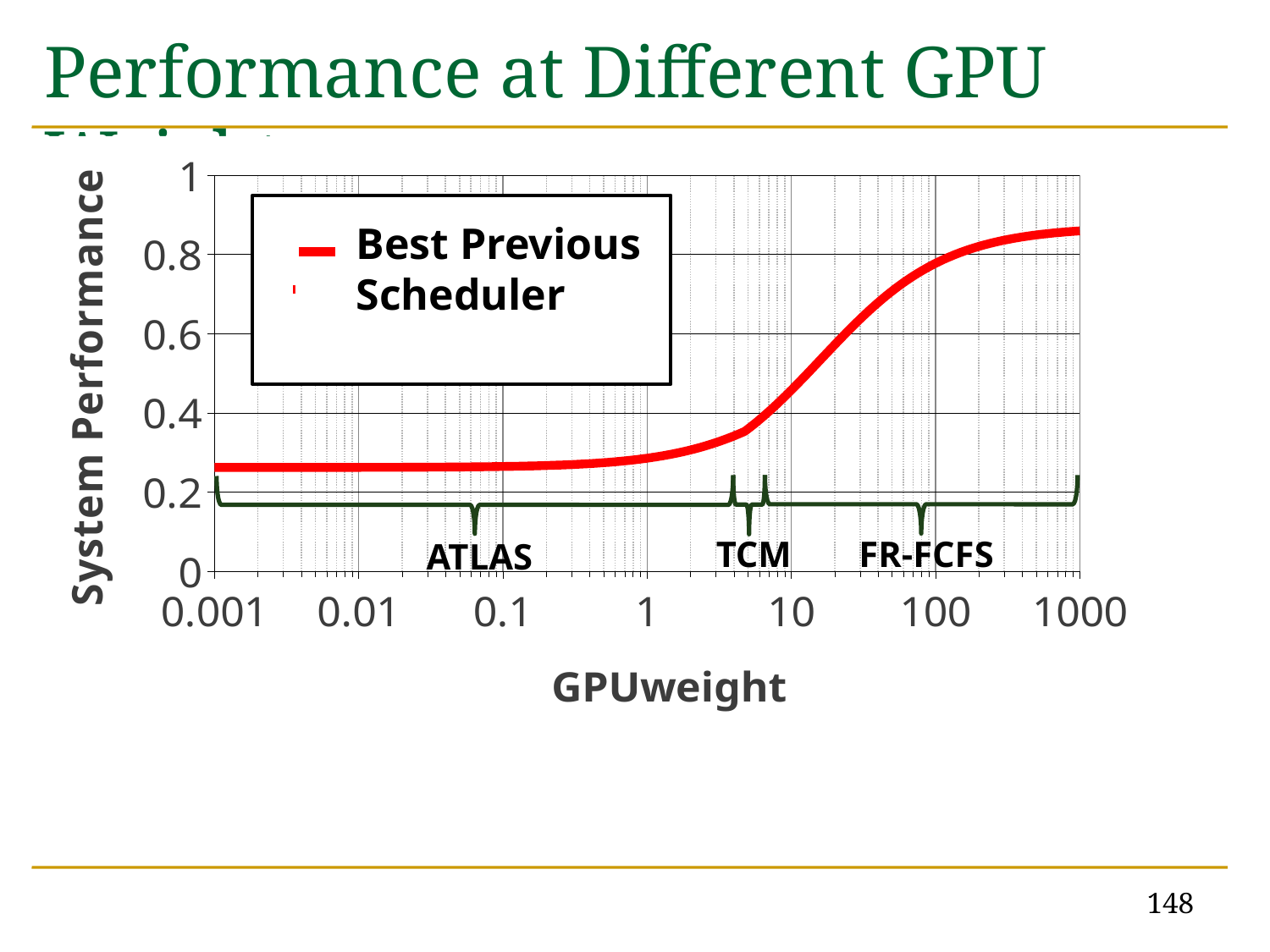
What is the label of the x axis of the chart? GPUweight Is the System Performance of the Best Previous Scheduler at GPUweight 0.001 greater or less than 0.4? less What is the name of the series shown in the chart legend? Best Previous Scheduler Does the System Performance of the Best Previous Scheduler rise or fall as GPUweight increases along the x axis? rise Which has the higher System Performance for the Best Previous Scheduler: GPUweight 0.01 or GPUweight 1000? GPUweight 1000 Is the System Performance of the Best Previous Scheduler at GPUweight 1000 greater or less than 0.6? greater Is the System Performance of the Best Previous Scheduler at GPUweight 1 greater or less than 0.4? less Which has the lower System Performance for the Best Previous Scheduler: GPUweight 0.1 or GPUweight 100? GPUweight 0.1 What kind of chart is shown on the slide? line chart How many series does the chart legend list? 1